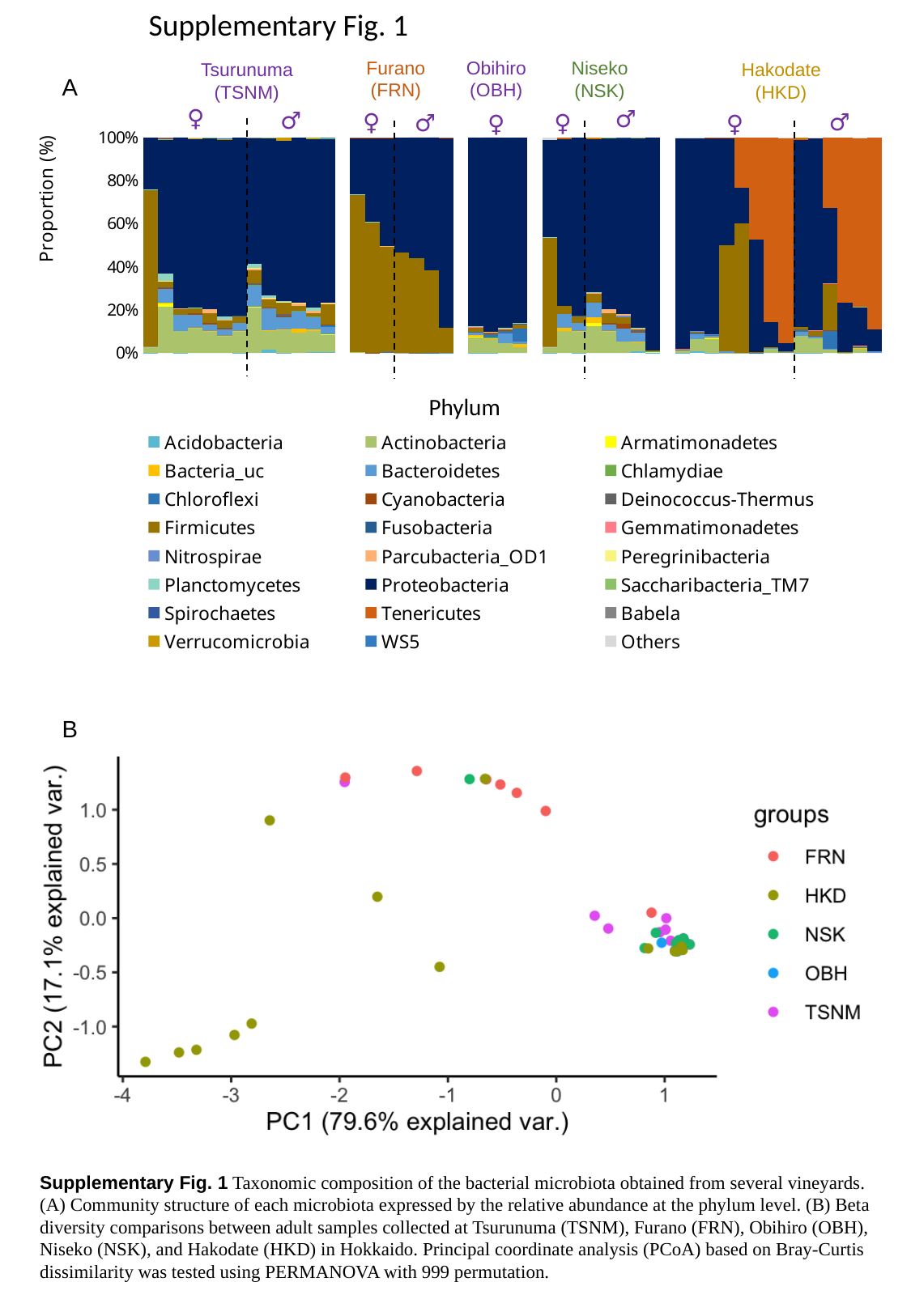
In panel A, how many entries does the Phylum legend list? 24 What kind of chart is panel A? bar chart In panel B, how many groups does the legend list? 5 In panel B, which group has points with PC1 values below -3? HKD In panel B, is the PC1 value of the leftmost point greater or less than -3? less In panel B, what percentage of variance is explained by PC1? 79.6% What kind of chart is panel B? scatter plot In panel A, what is the y-axis label? Proportion (%) In panel A, is the Firmicutes proportion in the first Furano female bar greater or less than 60%? greater In panel B, which group has the points with the lowest PC2 values? HKD In panel A, which vineyard has the largest proportion of Tenericutes in its male samples? Hakodate (HKD) In panel A, how many vineyards are shown along the top of the chart? 5